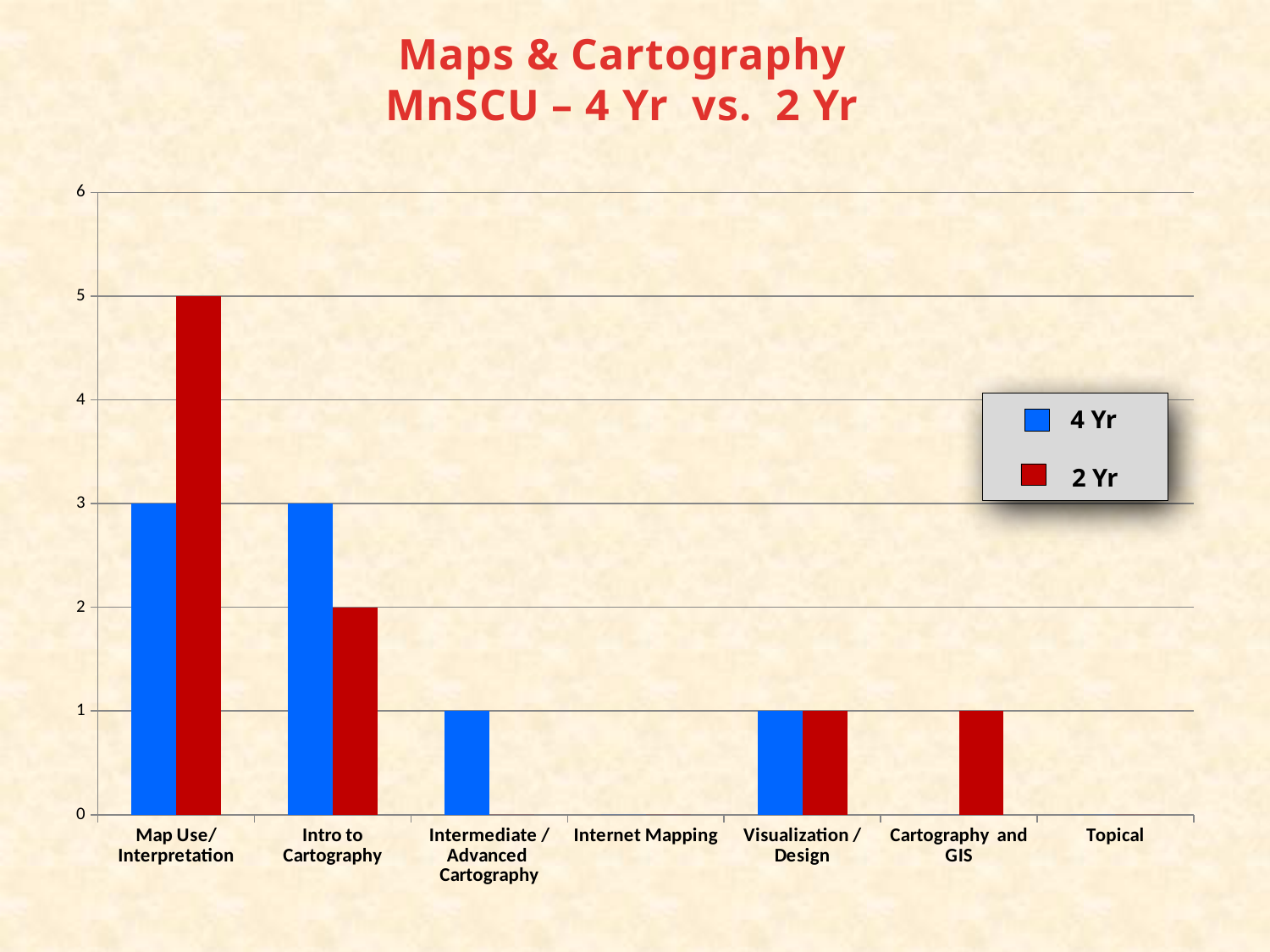
What is the title of the chart? Maps & Cartography MnSCU – 4 Yr vs. 2 Yr What is the difference between the 2 Yr and 4 Yr values for Map Use/Interpretation? 2 What is the 2 Yr value for Intro to Cartography? 2 Which category has the highest 2 Yr value? Map Use/Interpretation What is the 4 Yr value for Intro to Cartography? 3 Which series is shown in red in the legend? 2 Yr How many series does the legend list? 2 What kind of chart is shown on the slide? bar chart For Intro to Cartography, which is larger, the 4 Yr value or the 2 Yr value? 4 Yr What is the 2 Yr value for Map Use/Interpretation? 5 How many categories are shown on the x axis? 7 What is the 4 Yr value for Intermediate / Advanced Cartography? 1